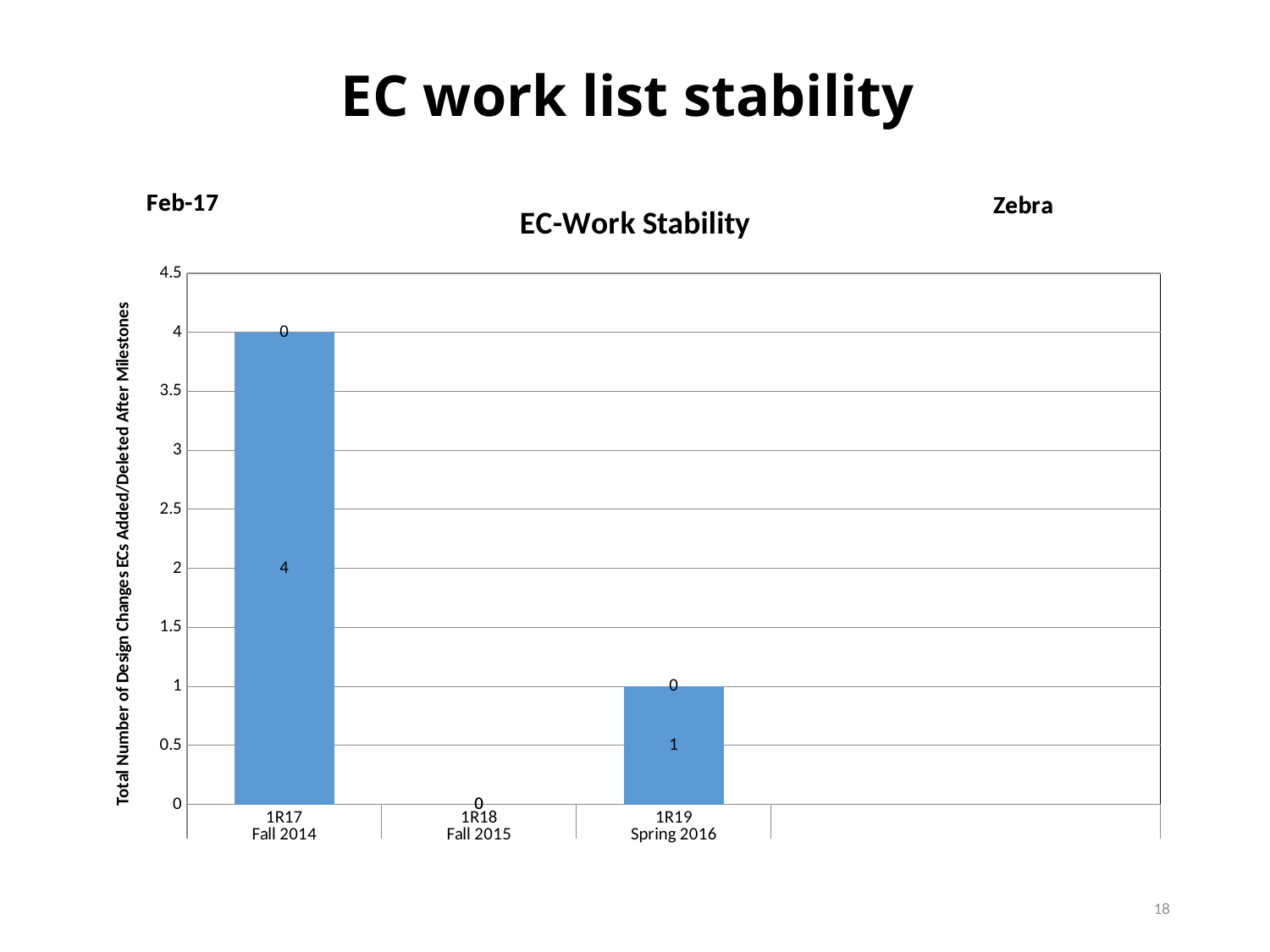
Which is larger, the blue bar for 1R17 Fall 2014 or the blue bar for 1R19 Spring 2016? 1R17 Fall 2014 Does the value fall or rise from 1R17 Fall 2014 to 1R18 Fall 2015? fall Which category has the highest bar in the EC-Work Stability chart? 1R17 Fall 2014 What is the title of the chart on the slide? EC-Work Stability What is the value shown for 1R18 Fall 2015 in the EC-Work Stability chart? 0 Which category has the lowest value in the EC-Work Stability chart? 1R18 Fall 2015 What is the value of the blue bar for 1R17 Fall 2014 in the EC-Work Stability chart? 4 Is the blue bar for 1R17 Fall 2014 greater or less than 3? greater What is the value of the blue bar for 1R19 Spring 2016 in the EC-Work Stability chart? 1 How many labeled categories are on the x axis of the EC-Work Stability chart? 3 What is the difference between the blue bar values for 1R17 Fall 2014 and 1R19 Spring 2016? 3 What kind of chart is the EC-Work Stability chart? bar chart